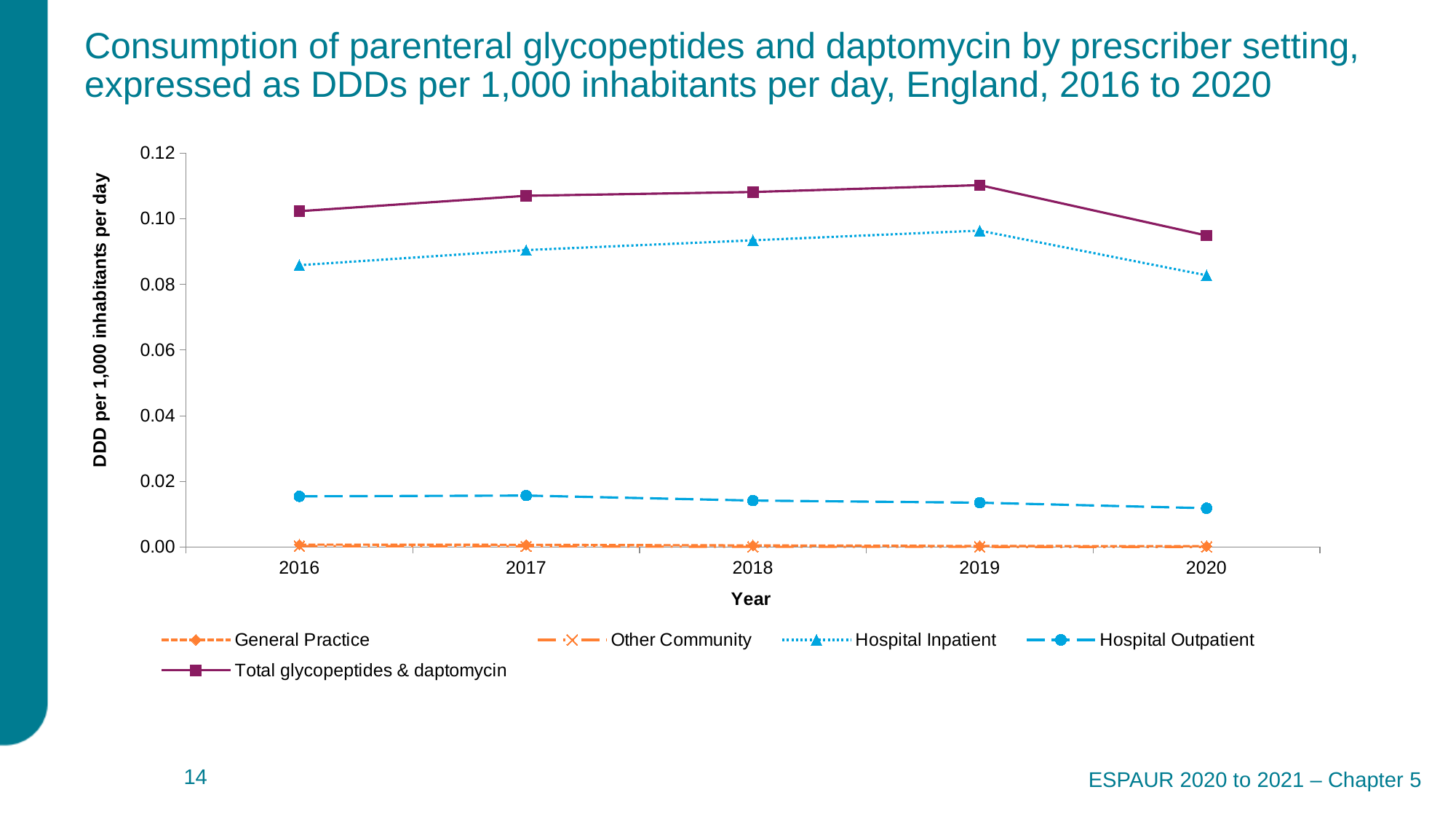
In which year is the Hospital Inpatient value highest? 2019 Which series has the highest values across all years? Total glycopeptides & daptomycin Is the Total glycopeptides & daptomycin value for 2020 greater or less than 0.10? less Is the Hospital Outpatient value for 2016 greater or less than 0.02? less How many years are plotted along the x axis? 5 In which year is the Total glycopeptides & daptomycin value lowest? 2020 Is the Hospital Inpatient value for 2016 greater or less than 0.08? greater In 2020, which is larger: Hospital Inpatient or Hospital Outpatient? Hospital Inpatient What kind of chart is shown on the slide? line chart Does the Total glycopeptides & daptomycin line rise or fall from 2019 to 2020? fall What is the label on the y axis? DDD per 1,000 inhabitants per day How many series does the legend list? 5